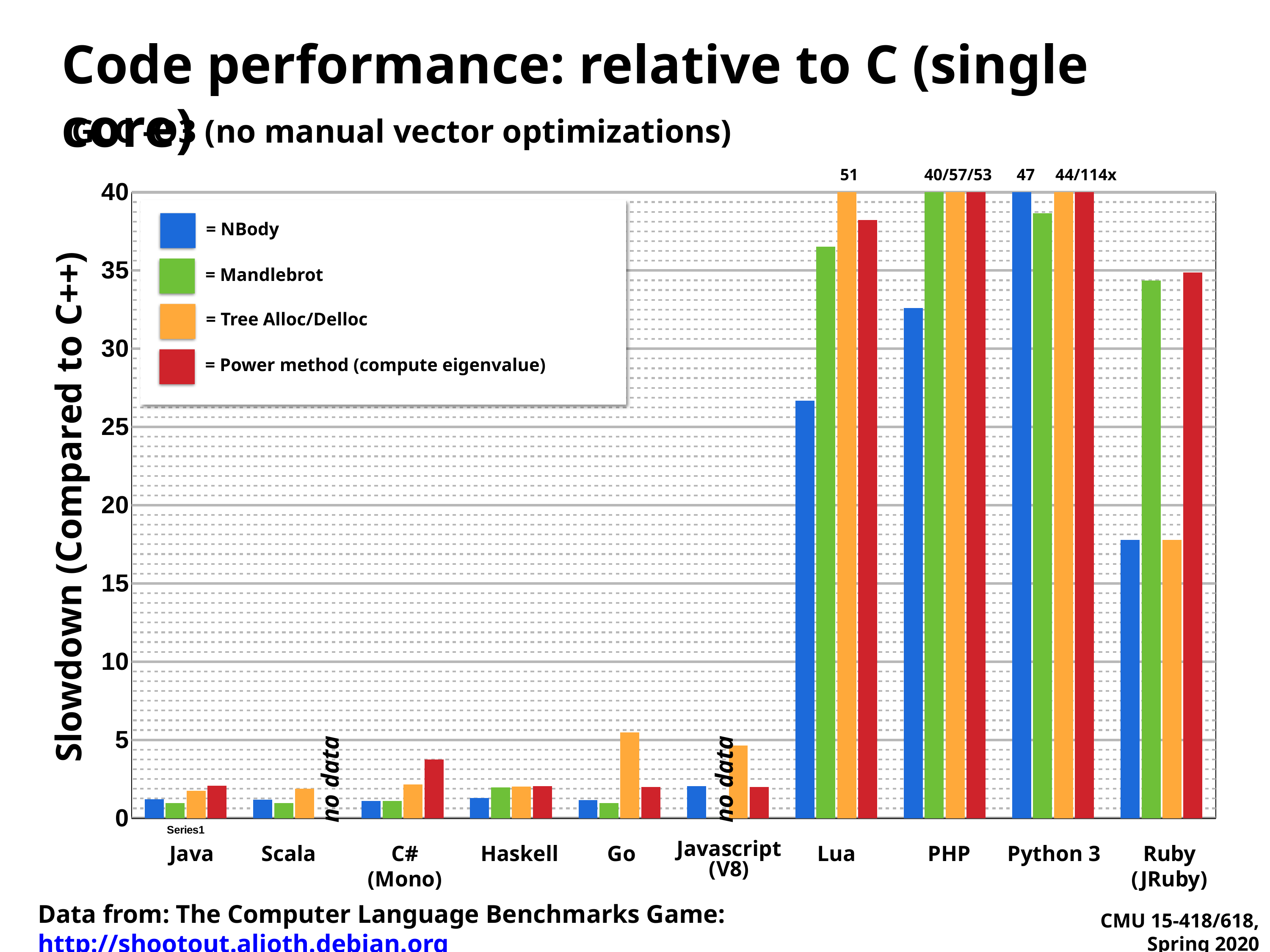
For Ruby (JRuby), which is larger: the Mandlebrot value or the NBody value? Mandlebrot Which language has the highest NBody value? Python 3 How many languages are shown along the x axis? 10 Is the NBody value for Ruby (JRuby) greater or less than 20? less What is the label on the y axis? Slowdown (Compared to C++) Which series has no data for Javascript (V8)? Mandlebrot How many series does the legend list? 4 Is the NBody value for PHP greater or less than 30? greater Which series is shown in red in the legend? Power method (compute eigenvalue) What kind of chart is shown on the slide? bar chart What value is annotated above the Lua Tree Alloc/Delloc bar? 51 What value is annotated above the Python 3 NBody bar? 47